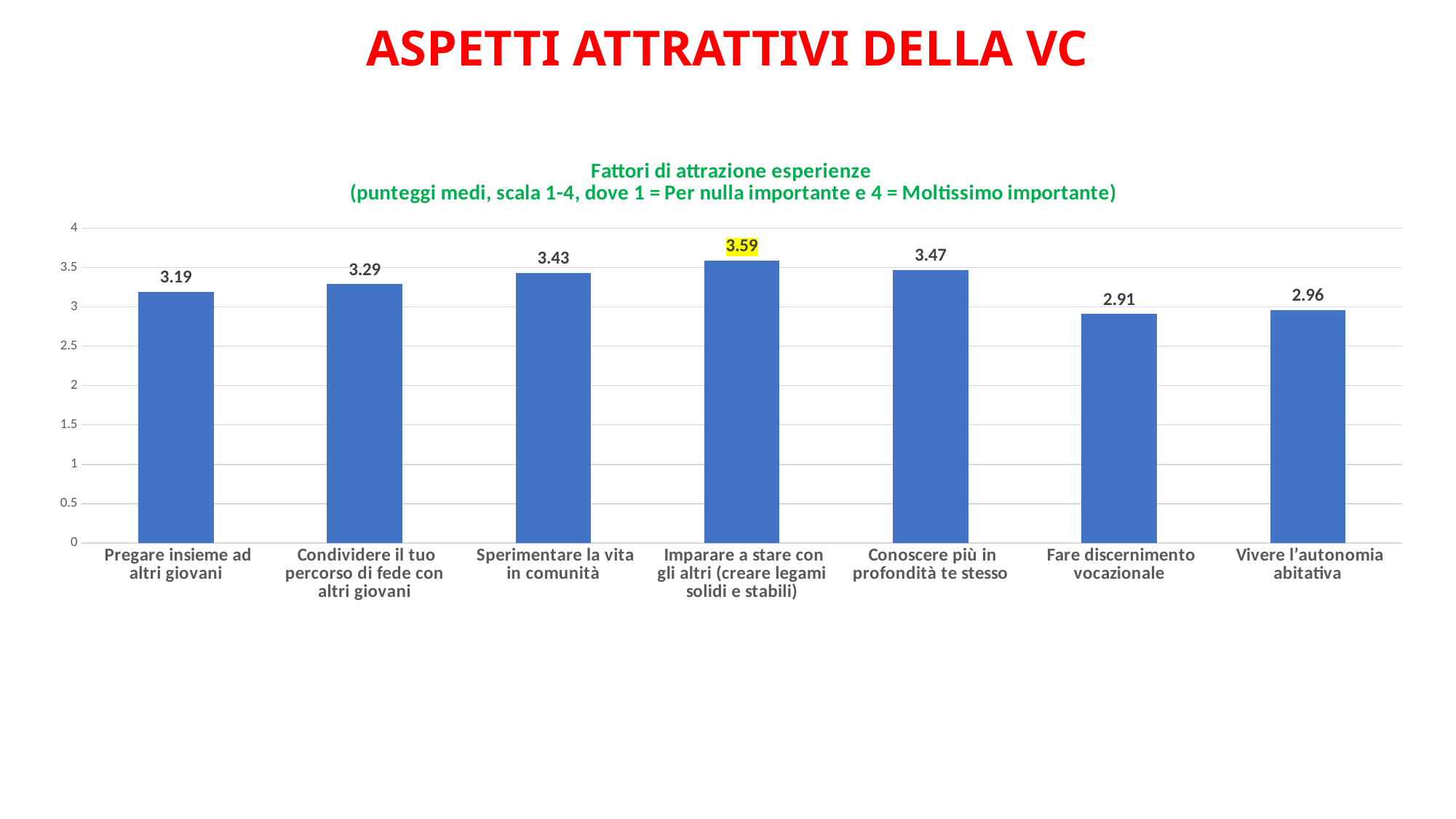
Which data label is highlighted in yellow? 3.59 Which category has the lowest value? Fare discernimento vocazionale What is the value for "Conoscere più in profondità te stesso"? 3.47 Which is larger, the value for "Sperimentare la vita in comunità" or the value for "Condividere il tuo percorso di fede con altri giovani"? Sperimentare la vita in comunità What is the value for "Pregare insieme ad altri giovani"? 3.19 Is the value for "Vivere l'autonomia abitativa" greater or less than 3? less How many categories are shown in the chart? 7 What is the value for "Fare discernimento vocazionale"? 2.91 What is the difference between the values for "Vivere l'autonomia abitativa" and "Fare discernimento vocazionale"? 0.05 Which category has the highest value? Imparare a stare con gli altri (creare legami solidi e stabili) What is the difference between the values for "Imparare a stare con gli altri (creare legami solidi e stabili)" and "Fare discernimento vocazionale"? 0.68 What kind of chart is shown on the slide? bar chart